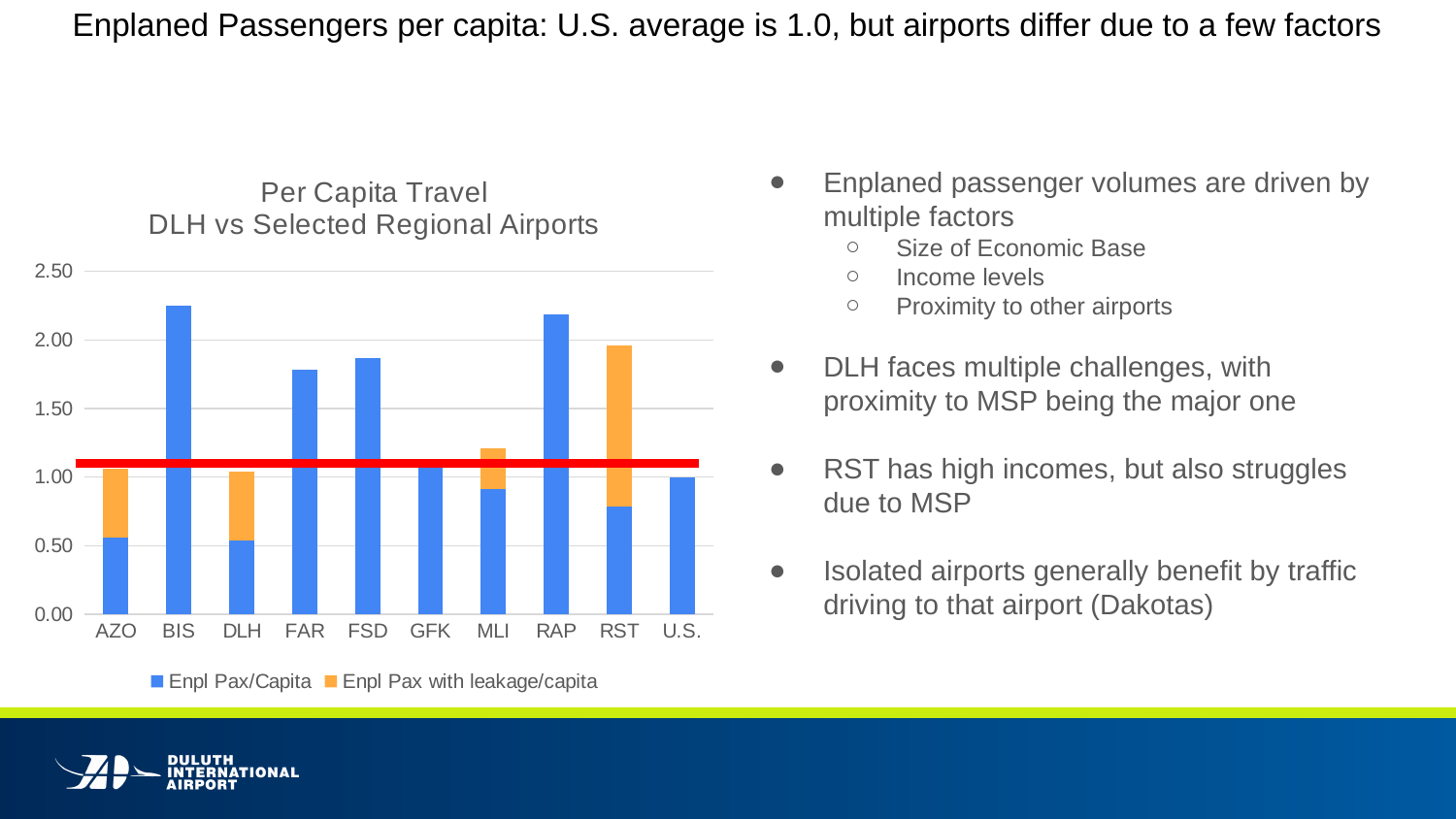
Is the Enpl Pax/Capita value for RAP greater or less than 2.00? greater Which is larger, the Enpl Pax/Capita value for RAP or for FSD? RAP Is the Enpl Pax/Capita value for FAR greater or less than 1.50? greater Is the Enpl Pax/Capita value for BIS greater or less than 2.00? greater How many series does the chart legend list? 2 How many airports/categories are shown on the x axis of the chart? 10 Which series in the legend is shown in orange? Enpl Pax with leakage/capita Which airport has the highest Enpl Pax/Capita bar? BIS Which is larger, the Enpl Pax/Capita value for FAR or for GFK? FAR What kind of chart is shown on the slide? Bar chart What is the title of the chart? Per Capita Travel DLH vs Selected Regional Airports